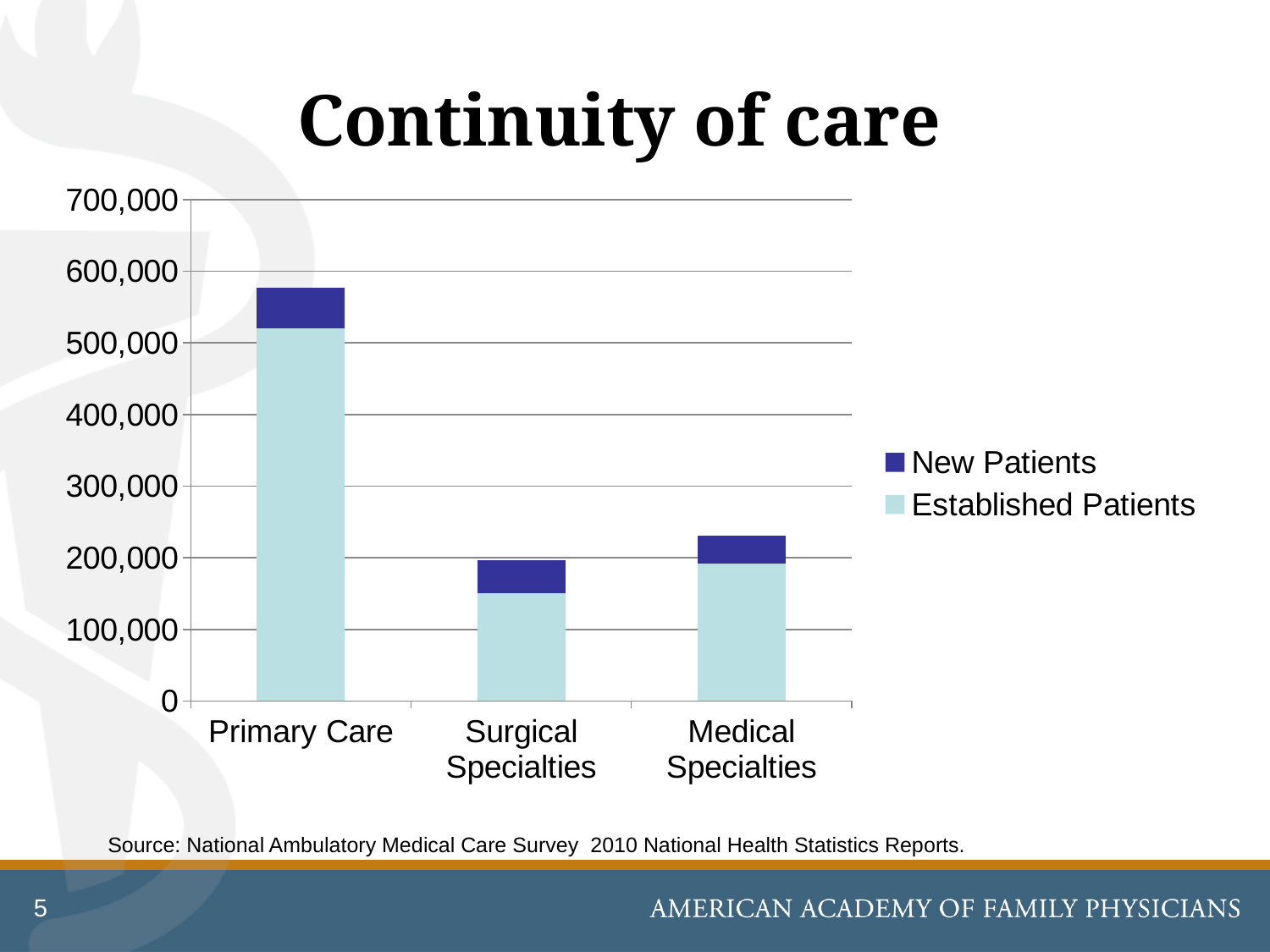
How many categories are shown on the x axis? 3 How many series does the legend list? 2 Is the total bar for Medical Specialties greater or less than 200,000? greater Which category has the shortest stacked bar? Surgical Specialties Is the total bar for Primary Care greater or less than 500,000? greater Which has a larger total bar, Medical Specialties or Surgical Specialties? Medical Specialties What is the title of the chart? Continuity of care Which series is shown in dark blue in the legend? New Patients Is the Established Patients value for Surgical Specialties greater or less than 200,000? less What kind of chart is shown on the slide? stacked bar chart Which category has the tallest stacked bar? Primary Care